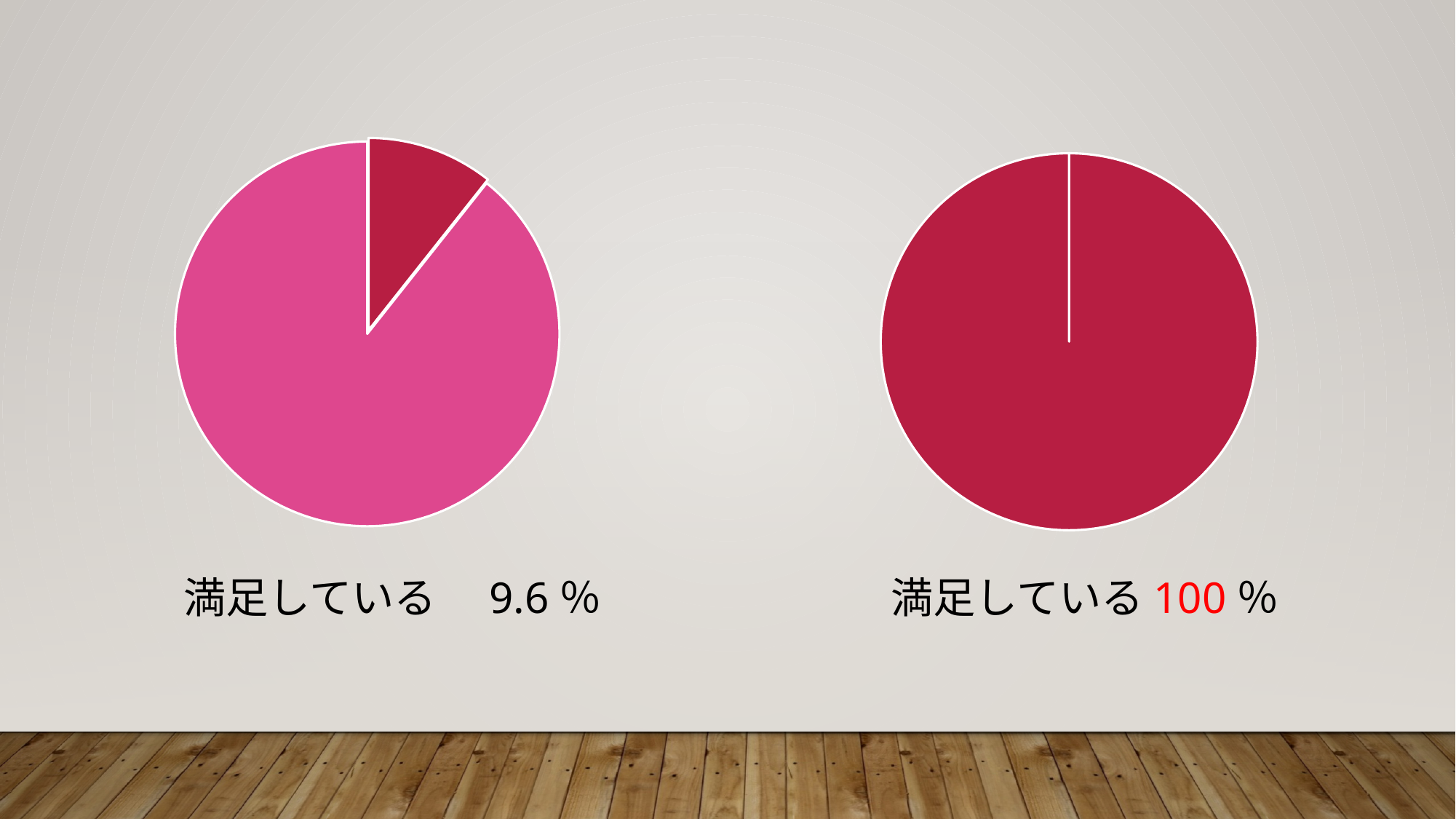
In the left pie chart, is the 満足している slice the larger or the smaller of the two slices? The smaller How many slices does the right pie chart have? 1 What kind of chart is shown on the left side of the slide? Pie chart What colour is the 満足している slice in the left pie chart? Dark red How many slices does the left pie chart have? 2 In which colour is the value 100 written in the caption under the right pie chart? Red In the left pie chart, what share is labelled 満足している? 9.6 % Which chart shows the larger share for 満足している, the left pie chart or the right pie chart? The right pie chart In the right pie chart, what share is labelled 満足している? 100 % In the left pie chart, is the share for 満足している greater or less than 50%? less What is the difference between the 満足している share in the right pie chart and the 満足している share in the left pie chart? 90.4 % What kind of chart is shown on the right side of the slide? Pie chart